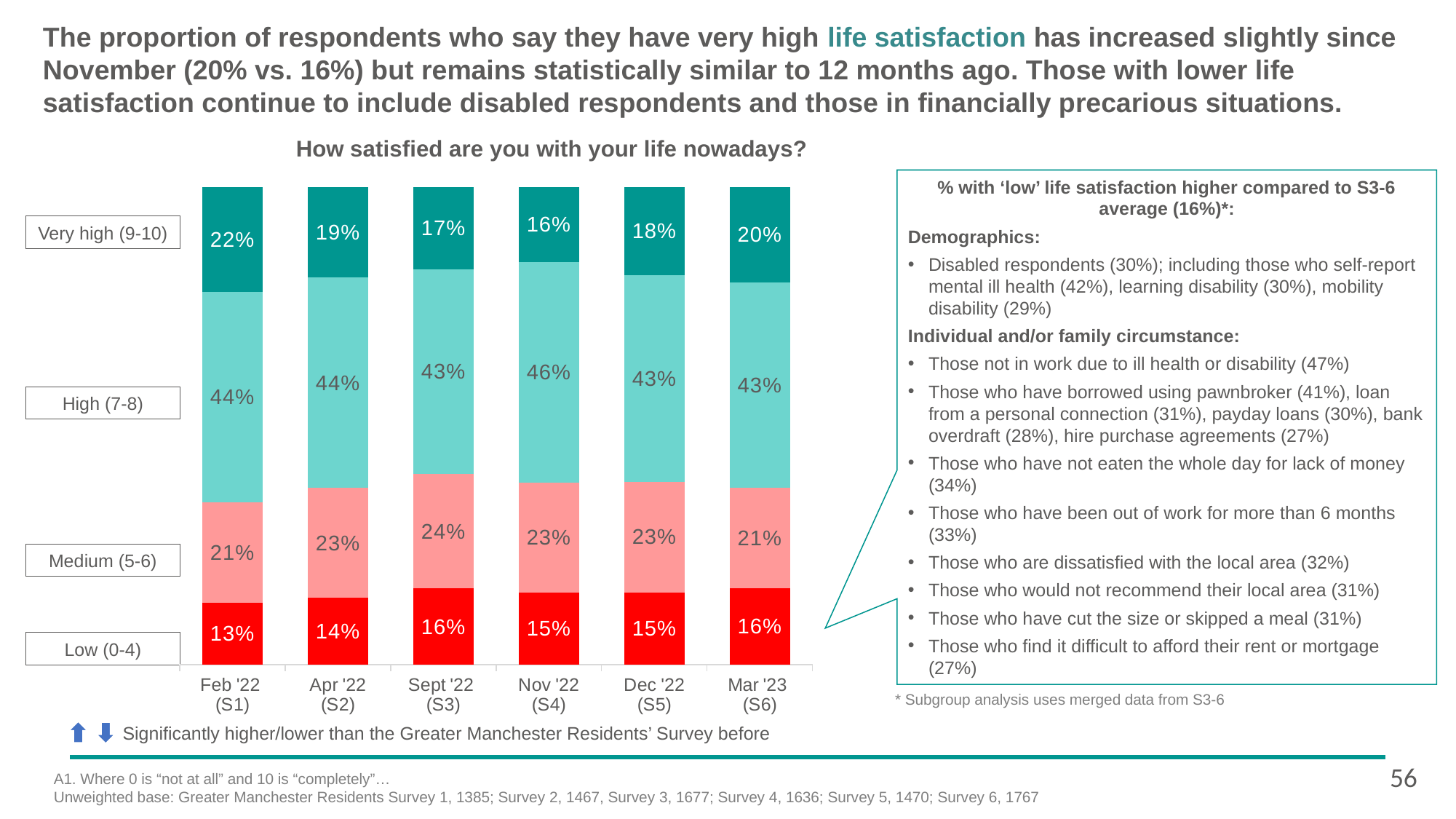
What is the difference in percentage points between the very high (9-10) share in Feb '22 (S1) and in Nov '22 (S4)? 6 percentage points What percentage of respondents reported medium (5-6) life satisfaction in Sept '22 (S3)? 24% What percentage of respondents reported low (0-4) life satisfaction in Feb '22 (S1)? 13% In which survey wave was the share of respondents with very high (9-10) life satisfaction the lowest? Nov '22 (S4) How many survey waves are shown on the x axis of the chart? 6 In which survey wave was the share of respondents with very high (9-10) life satisfaction the highest? Feb '22 (S1) How many life satisfaction categories are stacked in each bar? 4 Which survey wave has the larger share of respondents with high (7-8) life satisfaction, Nov '22 (S4) or Dec '22 (S5)? Nov '22 (S4) In which survey wave was the share of respondents with high (7-8) life satisfaction the highest? Nov '22 (S4) Did the share of respondents with very high (9-10) life satisfaction rise or fall from Feb '22 (S1) to Nov '22 (S4)? Fall What percentage of respondents reported very high (9-10) life satisfaction in Mar '23 (S6)? 20% What type of chart is used to show the life satisfaction results? Stacked bar chart